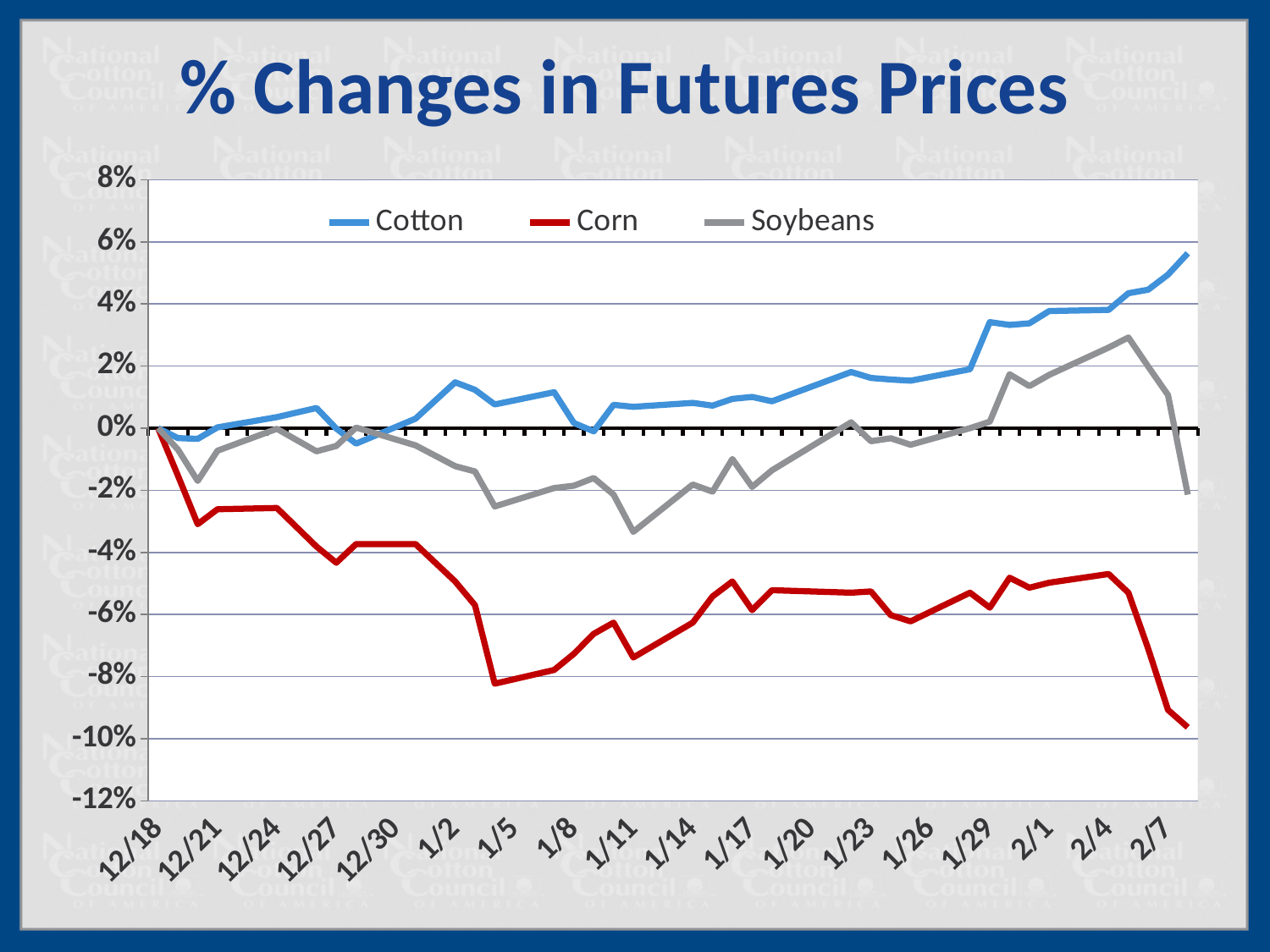
Does the Cotton line generally rise or fall from 12/18 to the end of the period? rise Is the final value for Cotton greater or less than 4%? greater How many series does the legend list? 3 What colour is the Corn line in the legend? red Which series has the lowest value at the end of the period? Corn What is the title of the chart? % Changes in Futures Prices Which series has the highest value at the end of the period (2/7 onward)? Cotton Is the value for Soybeans on 2/4 greater or less than 2%? greater Is the final value for Corn greater or less than -8%? less On 1/11, which series is higher, Cotton or Soybeans? Cotton What kind of chart is shown on the slide? line chart